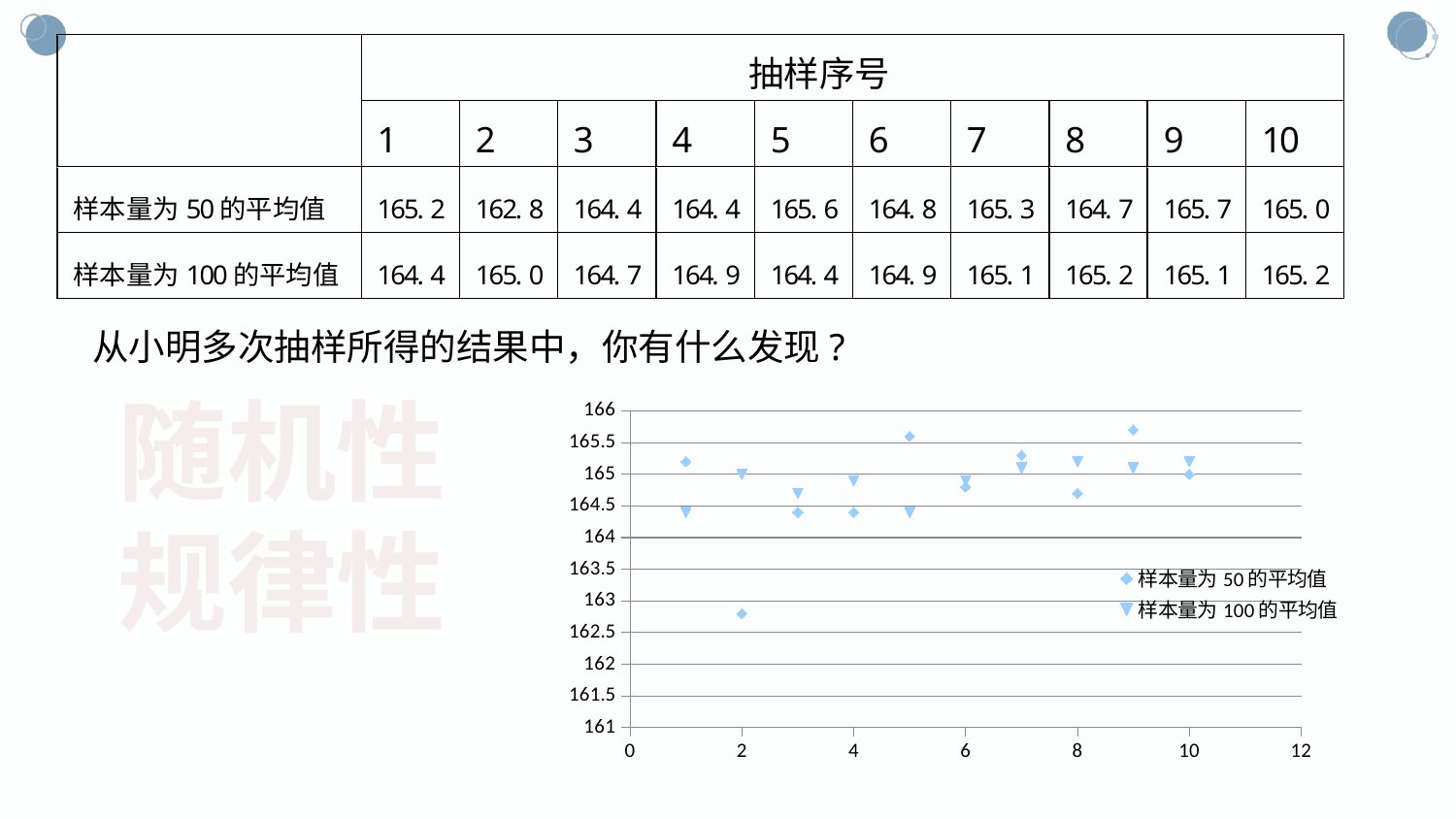
At sampling number 5, which series has the larger value? 样本量为 50 的平均值 How many sampling points (抽样序号) are plotted for each series in the chart? 10 What is the highest tick label shown on the chart's x axis? 12 What is the value of 样本量为 50 的平均值 at sampling number 2? 162.8 At sampling number 2, what is the difference between 样本量为 100 的平均值 and 样本量为 50 的平均值? 2.2 How many series does the chart's legend list? 2 Is the value for 样本量为 50 的平均值 at sampling number 2 greater or less than 163? less At which sampling number is 样本量为 50 的平均值 highest? 9 What kind of chart is shown on the slide? scatter chart What marker shape is used for 样本量为 100 的平均值 in the chart? triangle What is the value of 样本量为 100 的平均值 at sampling number 8? 165.2 At which sampling number is 样本量为 50 的平均值 lowest? 2